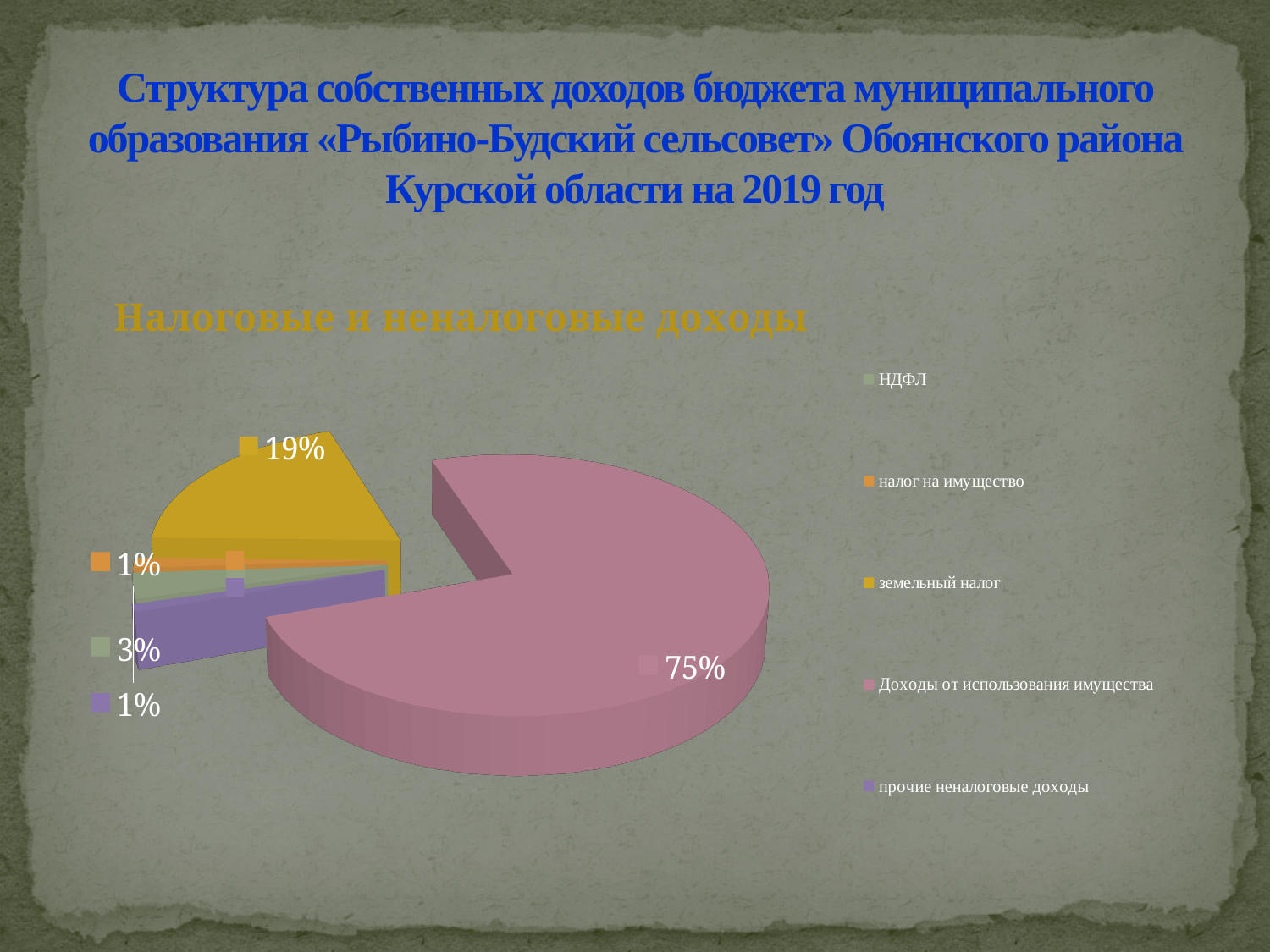
How many categories does the legend list? 5 What is the share for земельный налог? 19% What is the share for Доходы от использования имущества? 75% Which is larger, the share for НДФЛ or the share for налог на имущество? НДФЛ What is the title of the chart? Налоговые и неналоговые доходы What is the share for налог на имущество? 1% What kind of chart is shown on the slide? pie chart What colour is the slice for земельный налог? yellow What is the share for прочие неналоговые доходы? 1% Which category has the largest share of the pie? Доходы от использования имущества What is the difference in percentage points between Доходы от использования имущества and земельный налог? 56 What is the share for НДФЛ? 3%